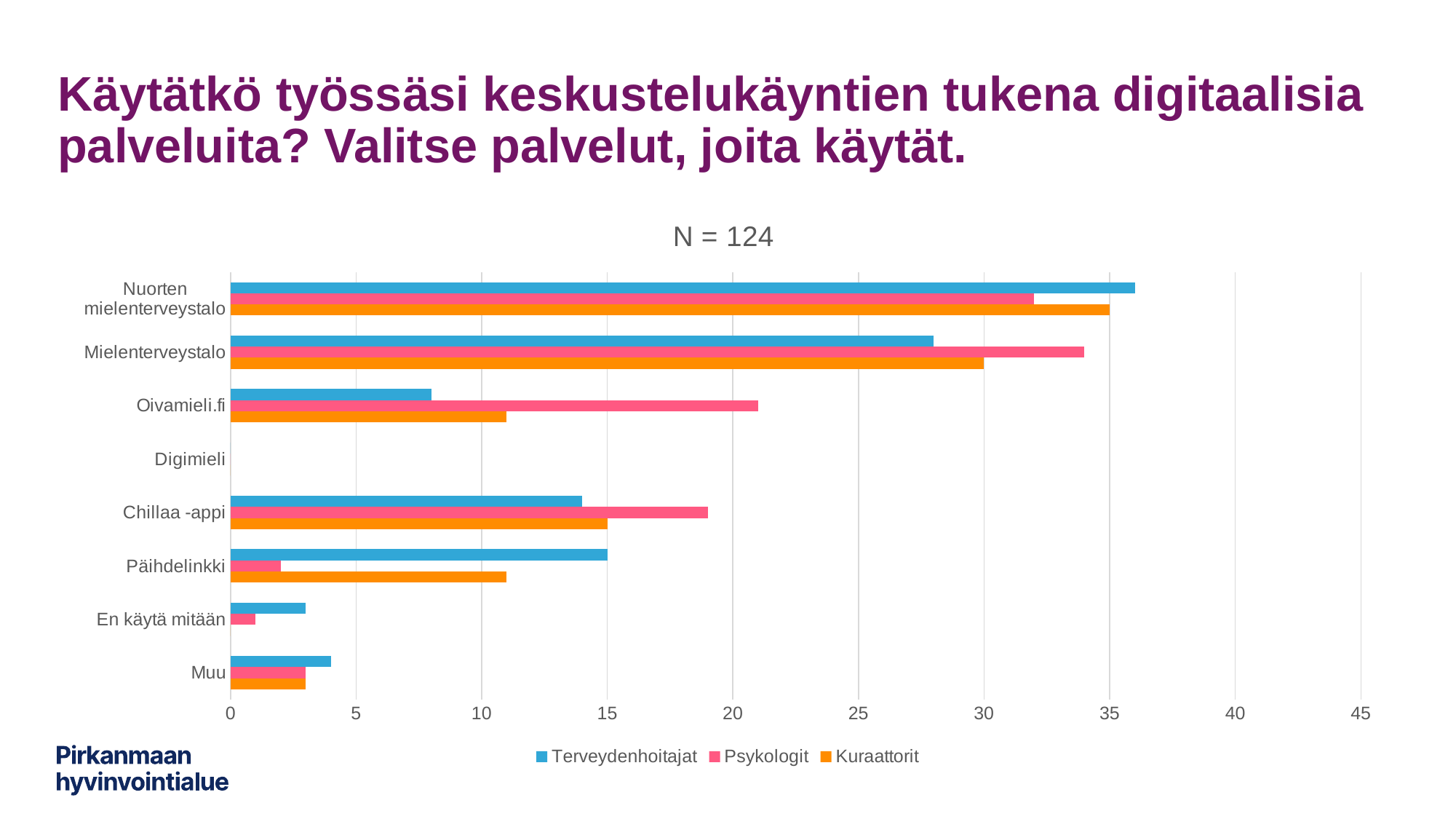
How many series does the legend list? 3 What is the value for Kuraattorit in the Mielenterveystalo category? 30 What is the value for Kuraattorit in the Nuorten mielenterveystalo category? 35 Which is larger in the Oivamieli.fi category: the value for Terveydenhoitajat or the value for Psykologit? Psykologit Which category has the highest value for Terveydenhoitajat? Nuorten mielenterveystalo What is the value for Terveydenhoitajat in the Päihdelinkki category? 15 Which category has the highest value for Psykologit? Mielenterveystalo What is the value for Kuraattorit in the Chillaa -appi category? 15 What sample size (N) is shown in the chart title? N = 124 How many categories are shown on the vertical axis of the chart? 8 What kind of chart is shown on the slide? bar chart Is the value for Psykologit in the Oivamieli.fi category greater or less than 20? greater